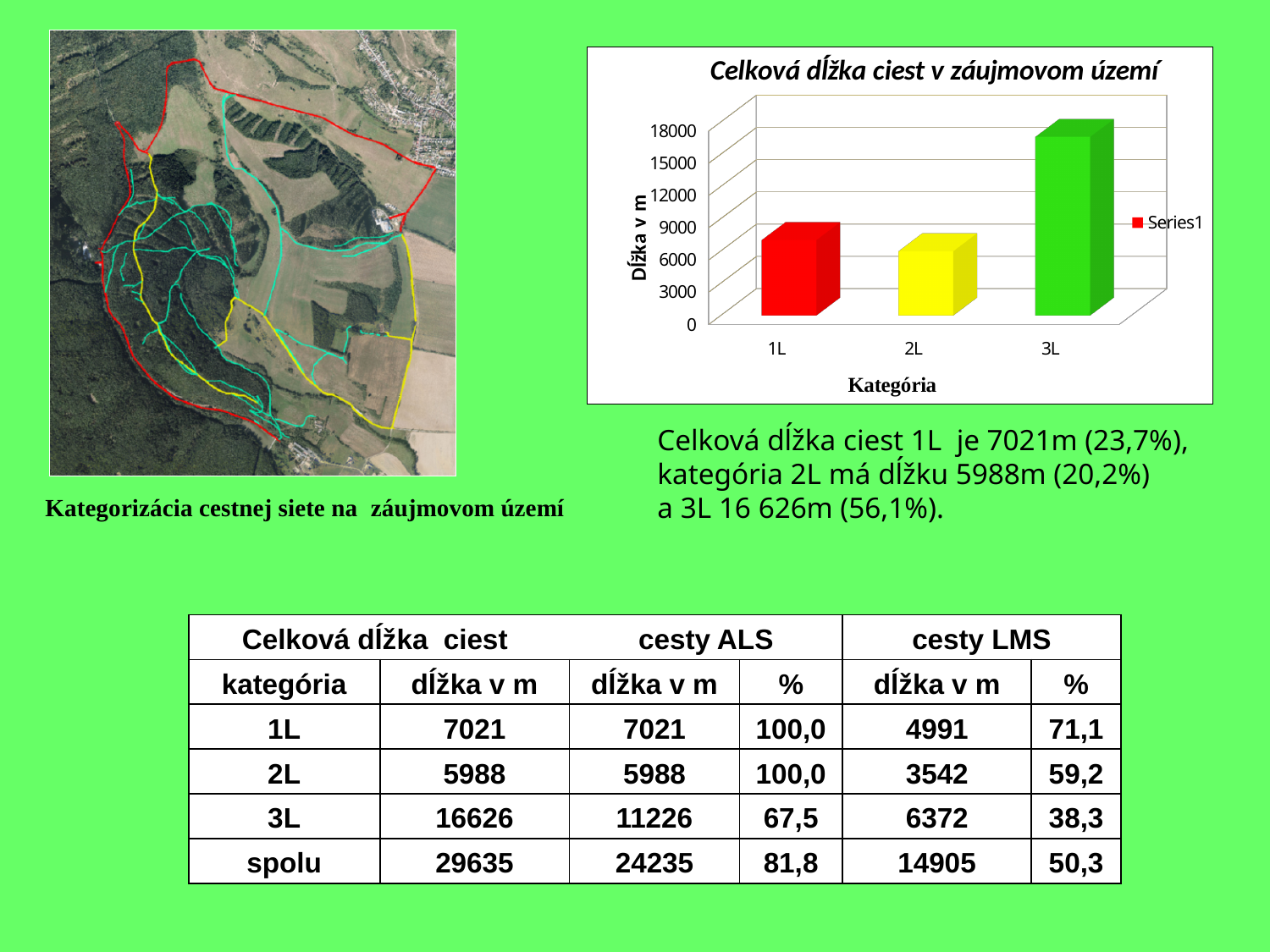
How many categories are shown on the x axis of the chart? 3 Which category has the highest bar in the chart? 3L Which bar is taller, 1L or 3L? 3L How many series does the chart legend list? 1 What is the label of the y axis of the chart? Dĺžka v m Is the value for 3L greater or less than 15000? greater Which category has the lowest bar in the chart? 2L What kind of chart is shown on the slide? bar chart What is the title of the chart? Celková dĺžka ciest v záujmovom území What is the label of the x axis of the chart? Kategória Is the value for 1L greater or less than 9000? less Is the value for 2L greater or less than 3000? greater